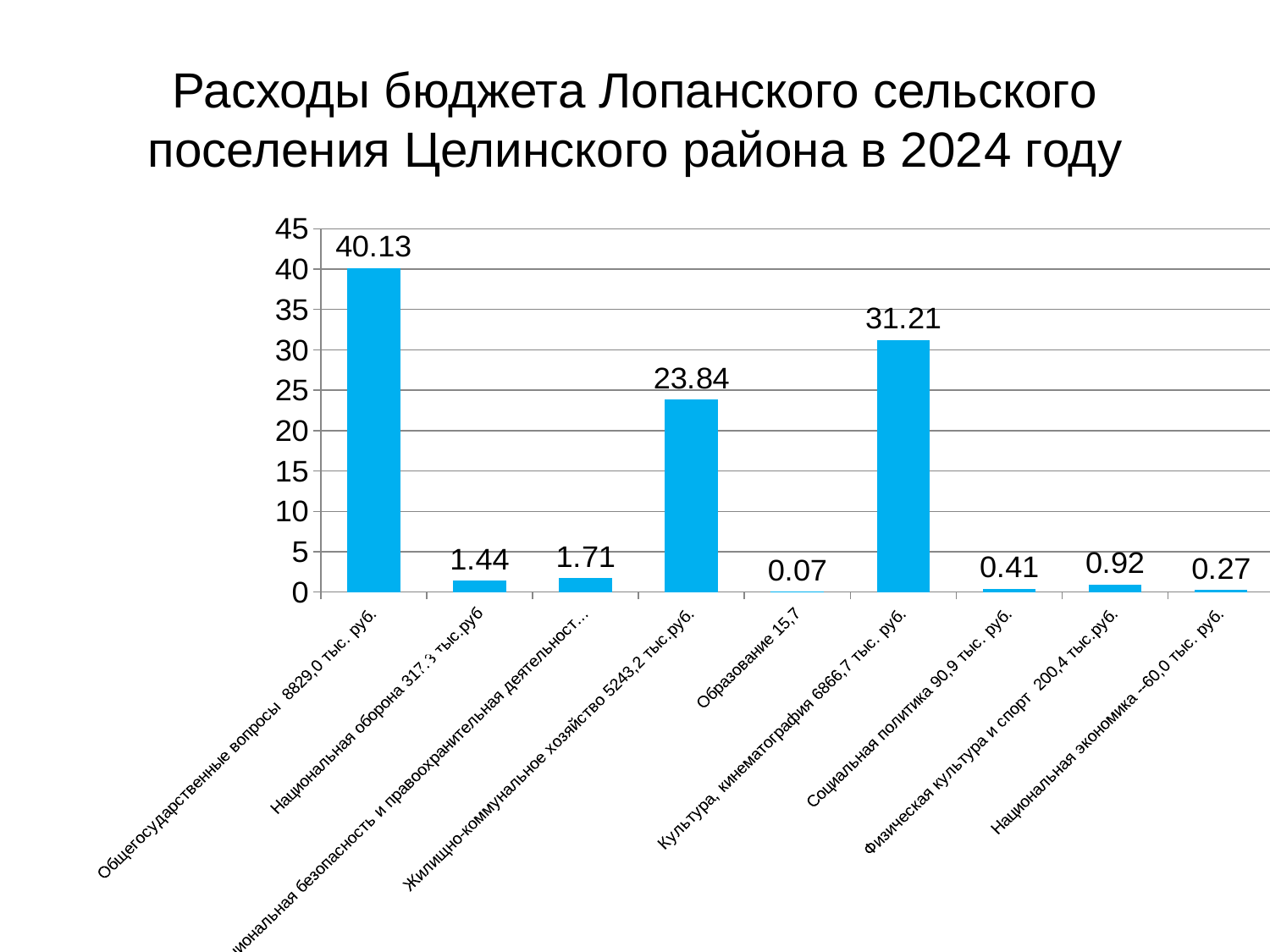
How many categories are plotted in the chart? 9 What is the title of the chart on the slide? Расходы бюджета Лопанского сельского поселения Целинского района в 2024 году Which category has the highest value? Общегосударственные вопросы What is the difference between the values for Общегосударственные вопросы and Культура, кинематография? 8.92 What is the value for Жилищно-коммунальное хозяйство? 23.84 Which is larger, the value for Национальная оборона or the value for Социальная политика? Национальная оборона What is the value for Культура, кинематография? 31.21 What type of chart is shown on the slide? bar chart What is the value for Общегосударственные вопросы? 40.13 What is the value for Физическая культура и спорт? 0.92 Which category has the lowest value? Образование What is the value for Образование? 0.07